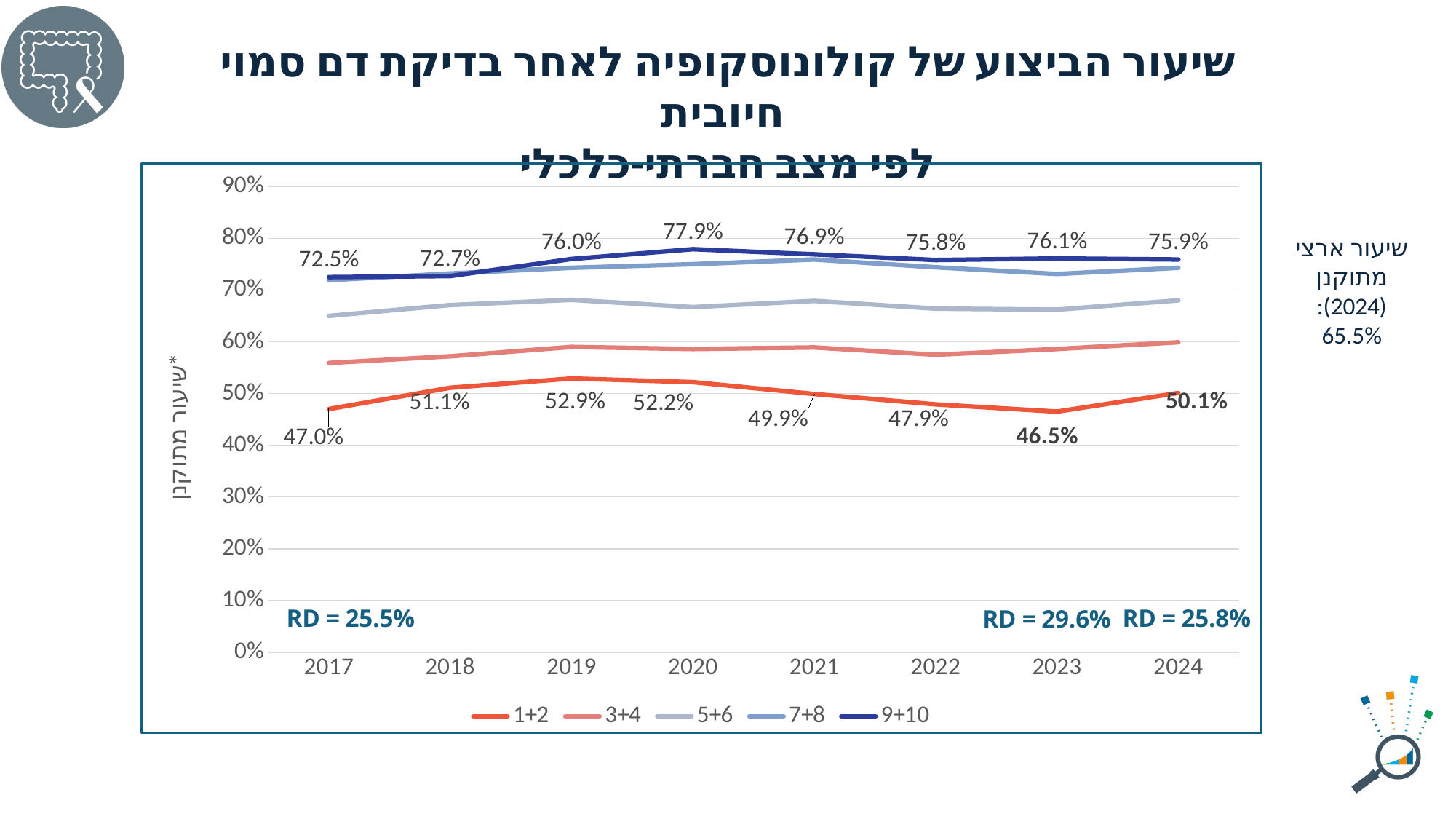
How many years are shown on the x axis? 8 How many series does the legend list? 5 In which year is the 1+2 series lowest? 2023 What is the RD value printed at the left of the chart for 2017? RD = 25.5% What kind of chart is shown on the slide? line chart In which year is the 9+10 series highest? 2020 What is the value for the 1+2 series in 2023? 46.5% Which is larger in 2017: the 1+2 series or the 3+4 series? 3+4 What is the difference between the 9+10 series and the 1+2 series in 2024? 25.8% What is the value for the 9+10 series in 2020? 77.9% Is the value for the 5+6 series in 2019 greater or less than 60%? greater What is the value for the 1+2 series in 2019? 52.9%